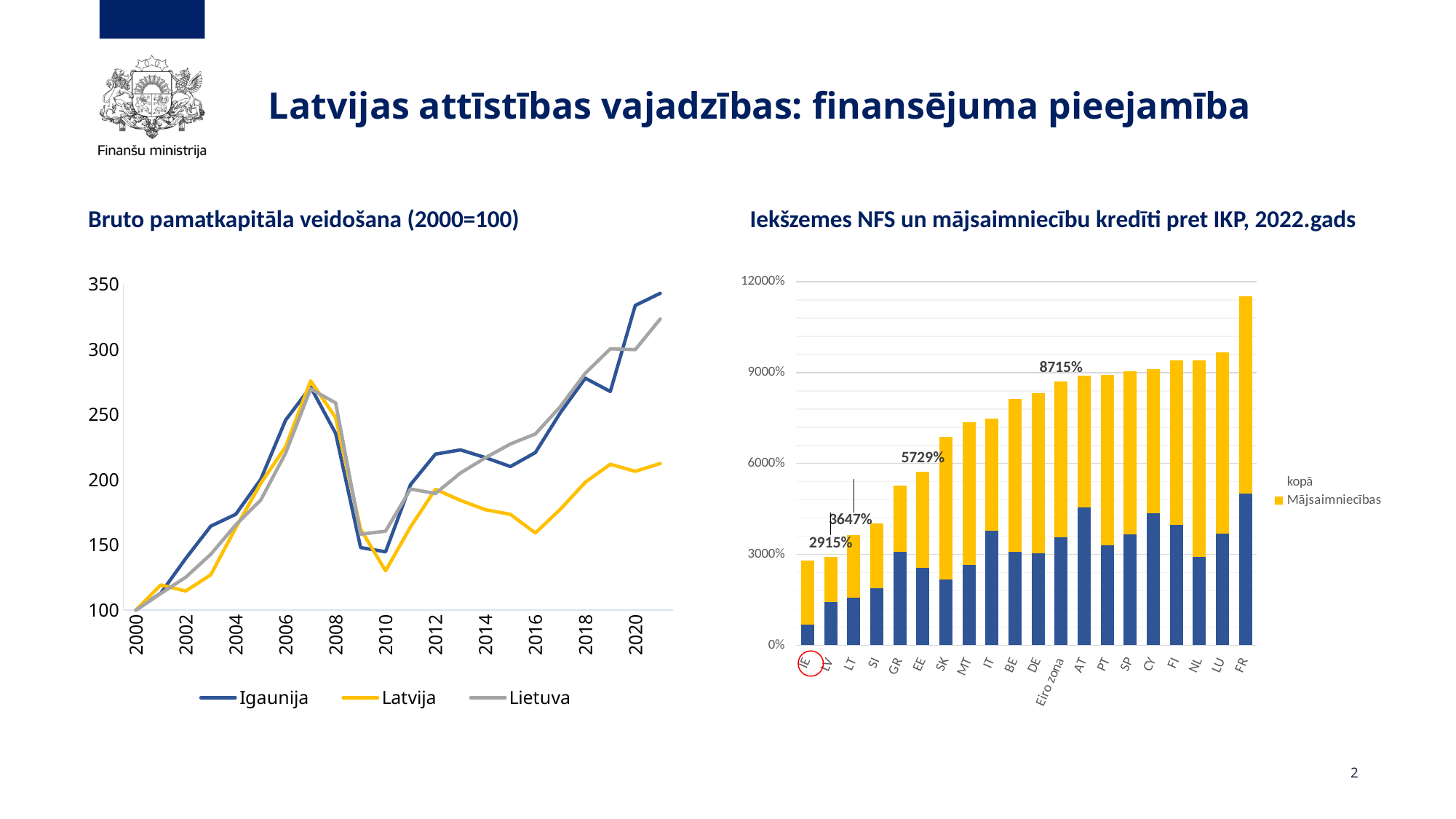
In the right chart 'Iekšzemes NFS un mājsaimniecību kredīti pret IKP, 2022.gads', which category has the lowest total bar? IE In the left chart 'Bruto pamatkapitāla veidošana (2000=100)', is the value for Latvija in 2020 greater or less than 250? less How many series does the legend of the left chart 'Bruto pamatkapitāla veidošana (2000=100)' list? 3 In the right chart 'Iekšzemes NFS un mājsaimniecību kredīti pret IKP, 2022.gads', what value is labelled for LV? 2915% How many categories are shown on the x axis of the right chart 'Iekšzemes NFS un mājsaimniecību kredīti pret IKP, 2022.gads'? 20 In the right chart 'Iekšzemes NFS un mājsaimniecību kredīti pret IKP, 2022.gads', which category has the highest total bar? FR What kind of chart is the right chart, 'Iekšzemes NFS un mājsaimniecību kredīti pret IKP, 2022.gads'? bar chart In the left chart 'Bruto pamatkapitāla veidošana (2000=100)', which series has the highest value in 2020? Igaunija In the left chart 'Bruto pamatkapitāla veidošana (2000=100)', is the value for Igaunija at the last point (2021) greater or less than 300? greater What kind of chart is the left chart, 'Bruto pamatkapitāla veidošana (2000=100)'? line chart